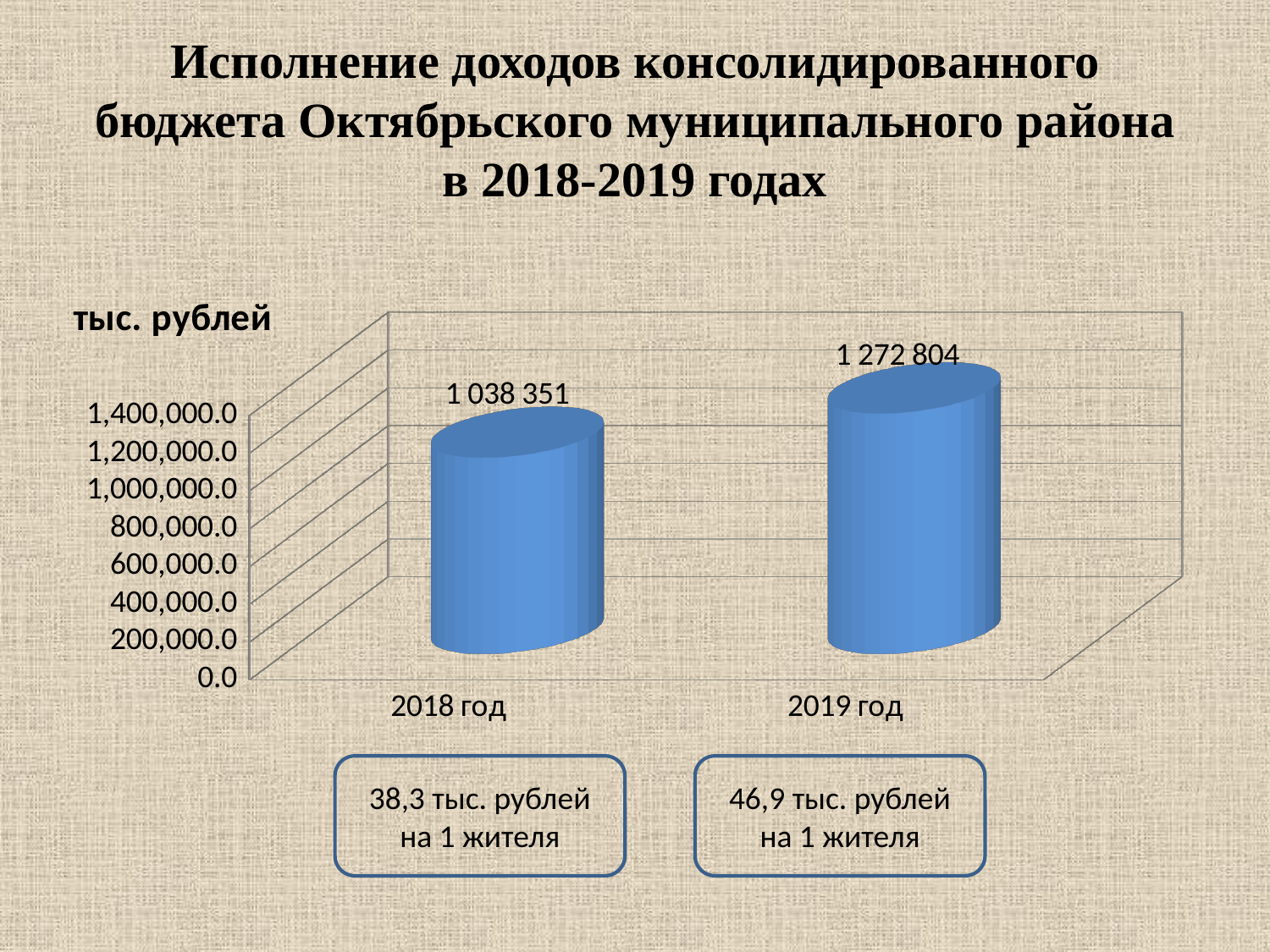
How many categories are shown on the x axis? 2 Is the value for 2018 год greater or less than 1,200,000.0? less Which year has the higher value? 2019 год Which year has the lower value? 2018 год Is the value for 2019 год greater or less than 1,200,000.0? greater What unit is shown for the vertical axis of the chart? тыс. рублей What is the difference between the values for 2019 год and 2018 год? 234 453 What kind of chart is shown on the slide? bar chart Do the values rise or fall from 2018 год to 2019 год? rise What is the value for 2019 год? 1 272 804 Is the value for 2018 год larger or smaller than the value for 2019 год? smaller What is the value for 2018 год? 1 038 351